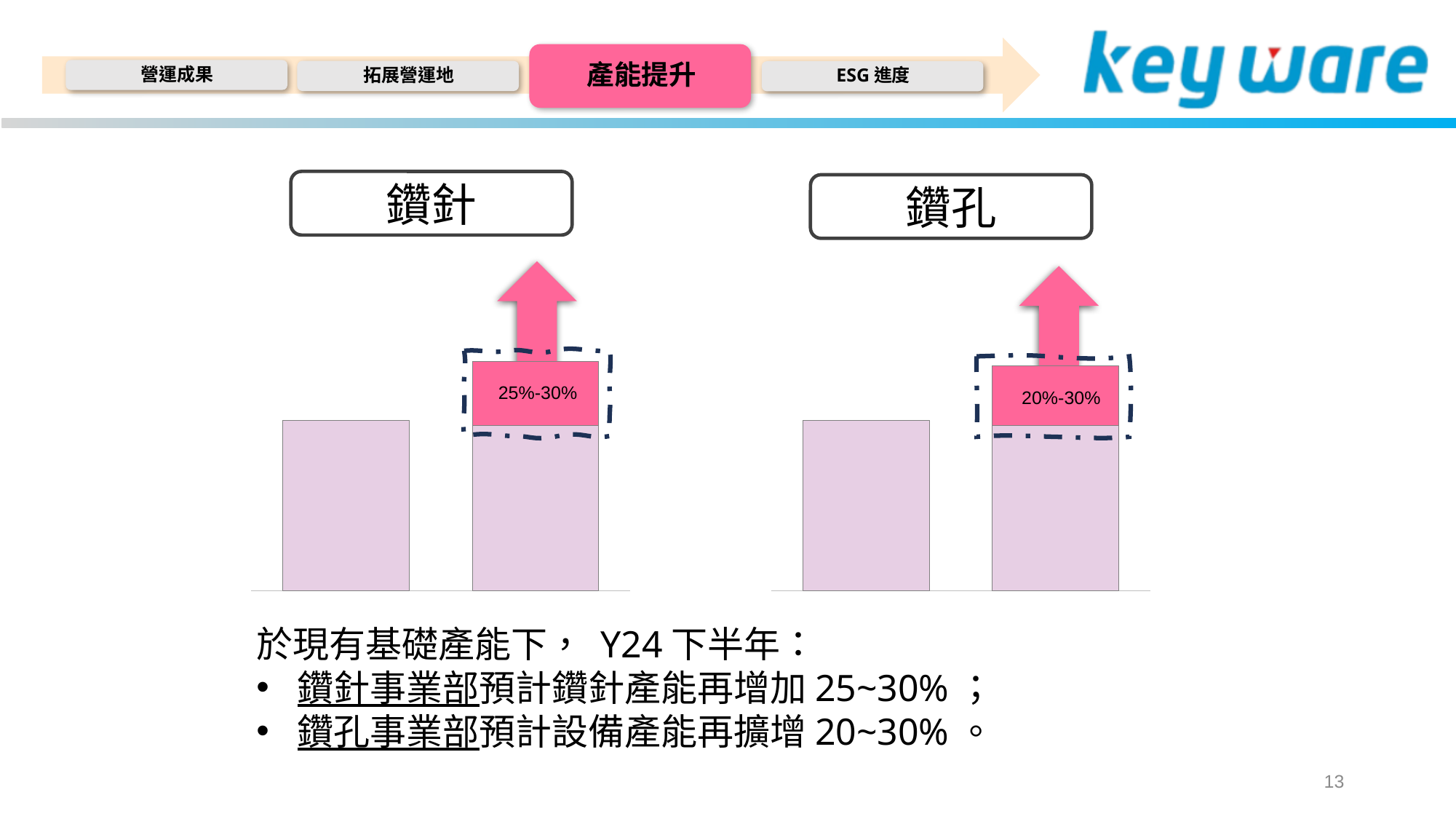
What kind of chart is shown under the 鑽孔 heading? Bar chart What kind of chart is shown under the 鑽針 heading? Bar chart What is the title shown above the right chart? 鑽孔 Do the bars rise or fall from left to right in the 鑽孔 chart? Rise In the 鑽孔 chart, what percentage increase is printed on the pink segment of the right-hand bar? 20%-30% In the 鑽針 chart, which bar is taller, the left bar or the right bar? The right bar What is the title shown above the left chart? 鑽針 How many bars are plotted in the 鑽孔 chart? 2 How many bars are plotted in the 鑽針 chart? 2 In the 鑽孔 chart, which bar is taller, the left bar or the right bar? The right bar In the 鑽針 chart, what percentage increase is printed on the pink segment of the right-hand bar? 25%-30% Do the bars rise or fall from left to right in the 鑽針 chart? Rise